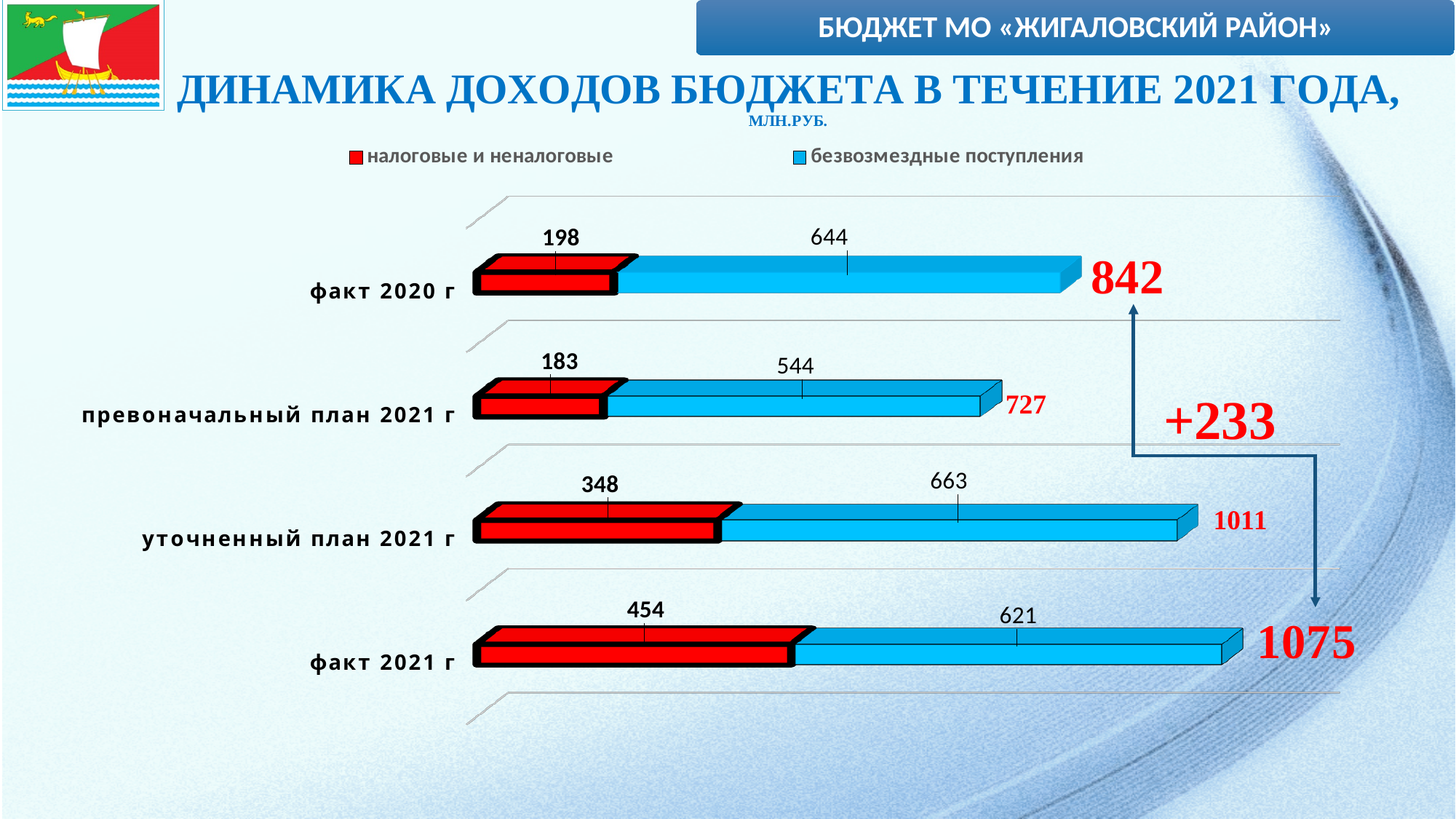
Which is larger: безвозмездные поступления for уточненный план 2021 г or for факт 2021 г? уточненный план 2021 г What is the value of безвозмездные поступления for уточненный план 2021 г? 663 How many series does the legend list? 2 What is the difference between налоговые и неналоговые for факт 2021 г and for факт 2020 г? 256 What is the value of безвозмездные поступления for факт 2020 г? 644 What is the total of the stacked bar for факт 2021 г? 1075 What is the total of the stacked bar for превоначальный план 2021 г? 727 Which category has the lowest value for безвозмездные поступления? превоначальный план 2021 г What is the value of налоговые и неналоговые for факт 2021 г? 454 How many categories are shown in the chart? 4 What kind of chart is shown on the slide? Stacked bar chart Which category has the highest value for налоговые и неналоговые? факт 2021 г